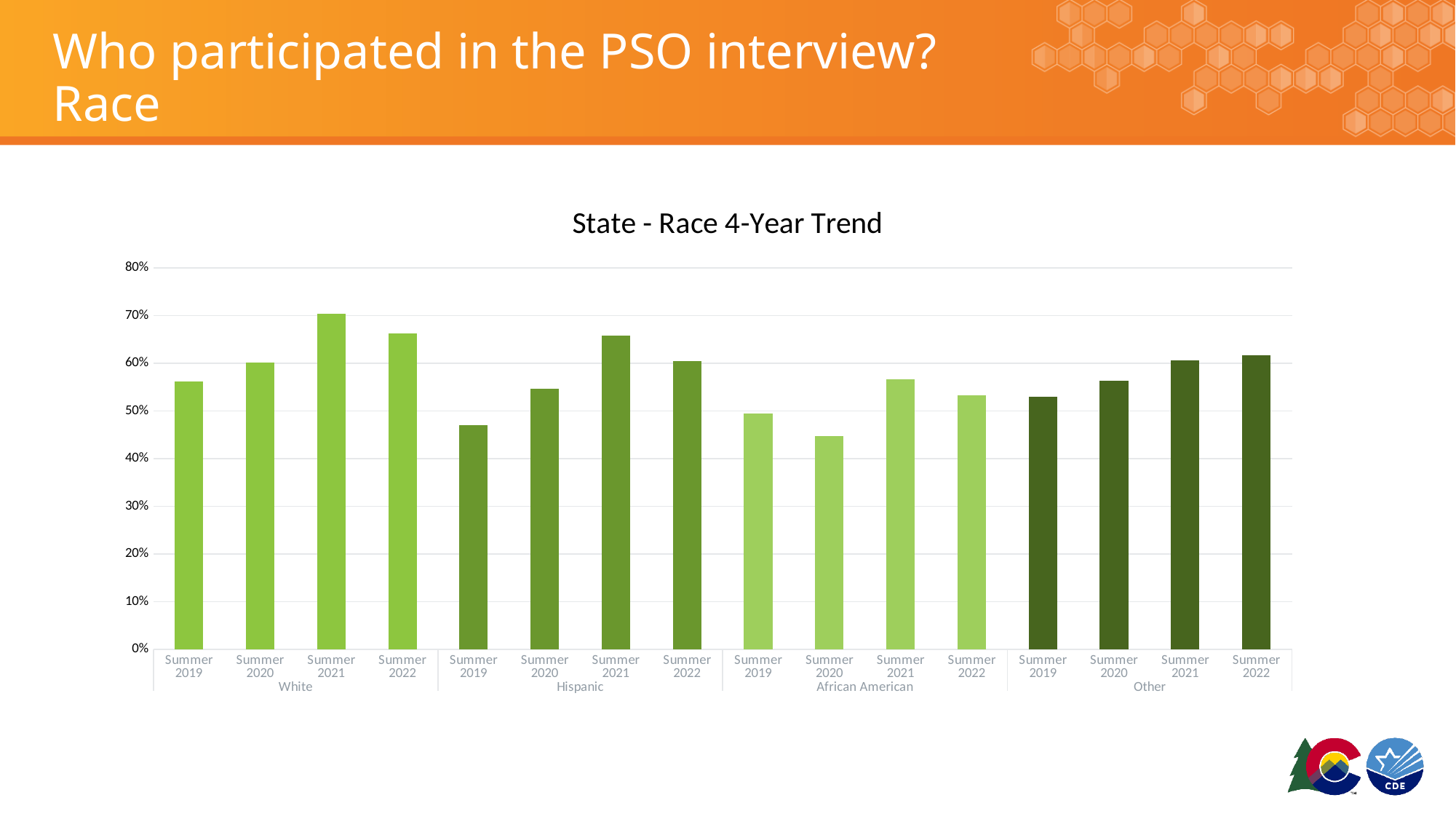
What kind of chart is shown on the slide? bar chart Is the value for African American in Summer 2020 greater or less than 50%? less Which bar is the highest in the chart? White, Summer 2021 What is the title of the chart? State - Race 4-Year Trend How many bars are plotted in the chart in total? 16 How many race groups are shown along the x axis of the chart? 4 Which is larger: the value for Hispanic in Summer 2021 or the value for African American in Summer 2021? Hispanic in Summer 2021 Is the value for White in Summer 2021 greater or less than 60%? greater Is the value for Hispanic in Summer 2019 greater or less than 50%? less Which bar is the lowest in the chart? African American, Summer 2020 Do the values for the Other group rise or fall from Summer 2019 to Summer 2022? rise Which is larger: the value for White in Summer 2021 or the value for Hispanic in Summer 2021? White in Summer 2021